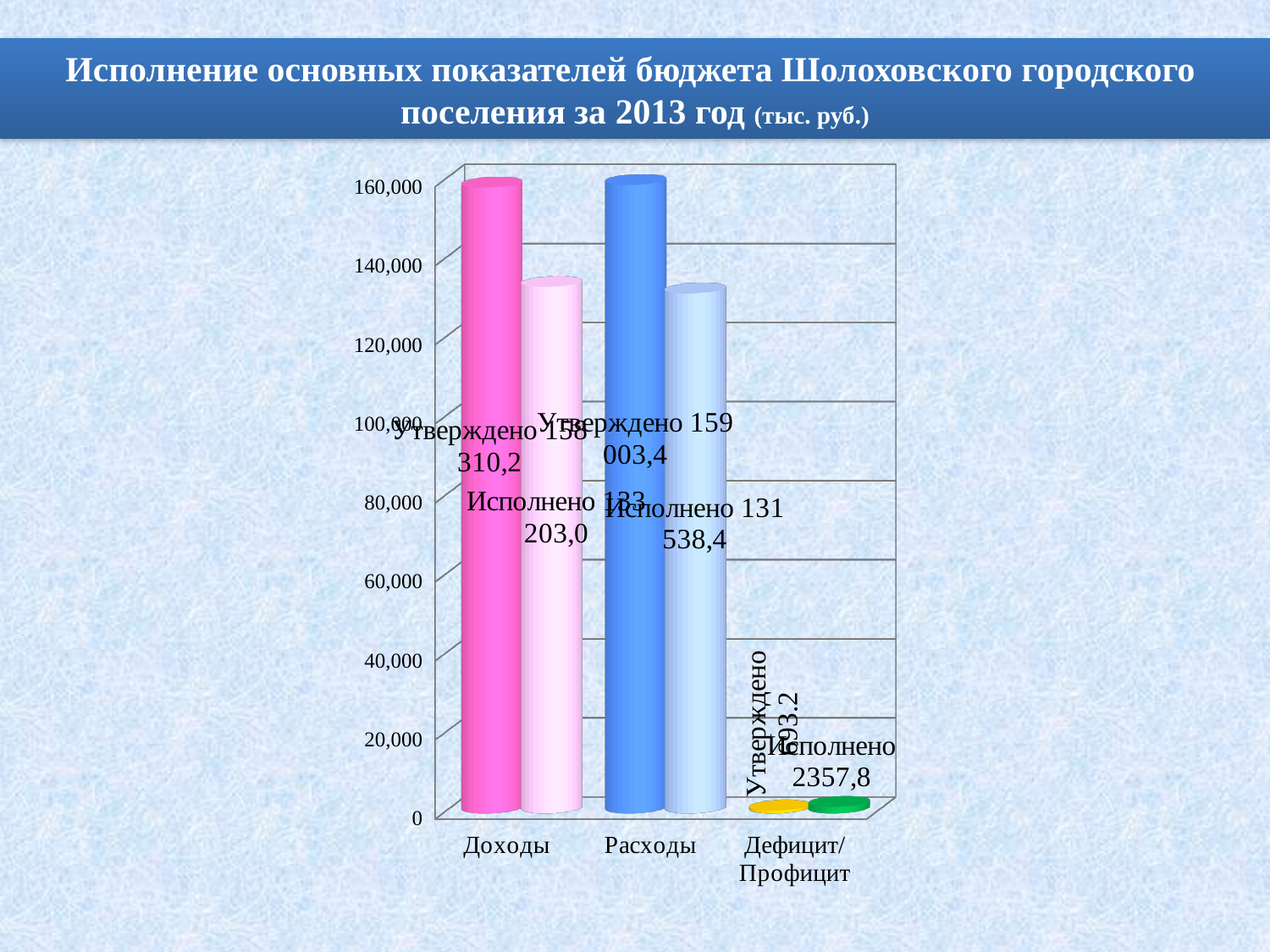
Which category has the lowest values in the chart? Дефицит/Профицит Is the Утверждено value for Доходы greater or less than 140,000? greater Which is larger: the Утверждено value for Доходы or the Утверждено value for Расходы? Расходы In what units are the values in the chart expressed, according to the slide title? тыс. руб. Is the Исполнено value for Расходы greater or less than 140,000? less How many categories are shown on the x axis of the chart? 3 What kind of chart is shown on the slide? bar chart What is the Исполнено value for Дефицит/Профицит? 2357,8 What is the Утверждено value for Доходы? 158 310,2 What is the Исполнено value for Расходы? 131 538,4 What is the Утверждено value for Расходы? 159 003,4 What is the difference between the Утверждено and Исполнено values for Расходы? 27 465,0